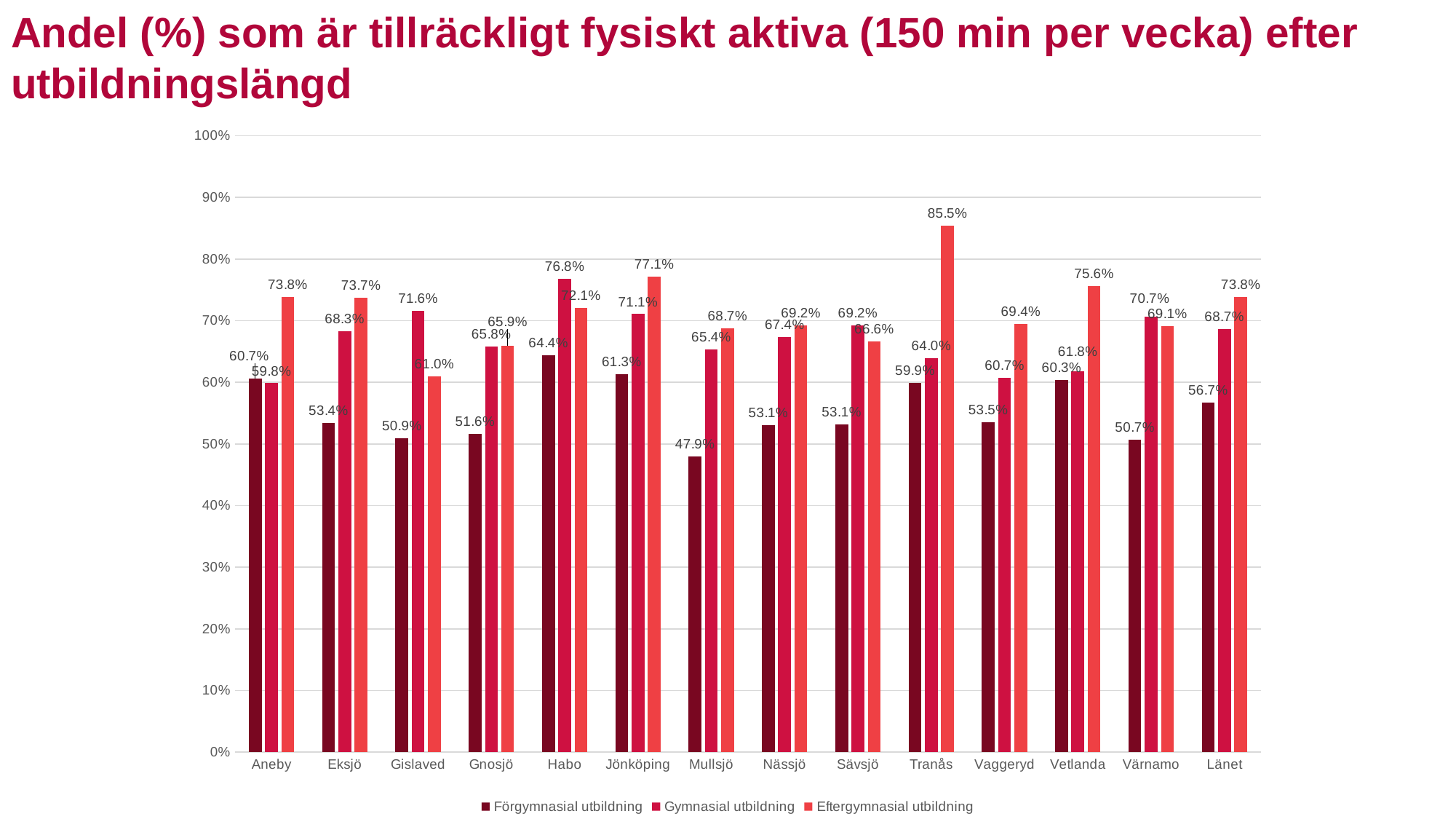
What is the value for Förgymnasial utbildning in Mullsjö? 47.9% What kind of chart is shown on the slide? Bar chart What is the difference between Eftergymnasial utbildning and Förgymnasial utbildning in Tranås? 25.6 percentage points Which municipality has the lowest value for Förgymnasial utbildning? Mullsjö How many municipalities/categories are shown on the x axis? 14 Which municipality has the highest value for Förgymnasial utbildning? Habo Which municipality has the highest value for Eftergymnasial utbildning? Tranås What is the value for Eftergymnasial utbildning for Länet? 73.8% What is the value for Gymnasial utbildning in Habo? 76.8% Which is larger in Gislaved: Gymnasial utbildning or Eftergymnasial utbildning? Gymnasial utbildning What is the value for Eftergymnasial utbildning in Tranås? 85.5% How many series does the legend list? 3